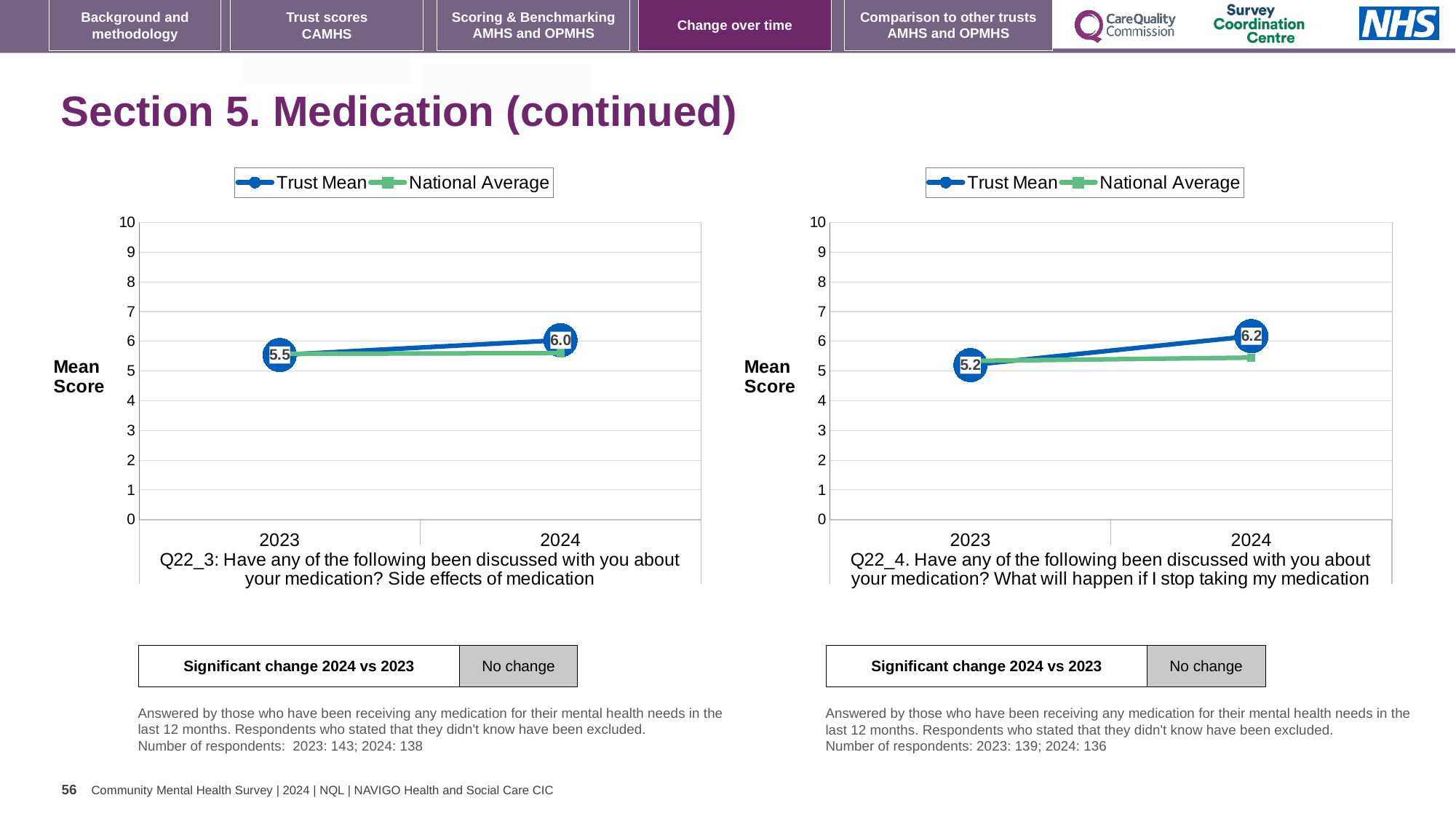
In the left chart (Q22_3), does the Trust Mean rise or fall from 2023 to 2024? rise In the left chart (Q22_3), by how much did the Trust Mean change from 2023 to 2024? 0.5 How many series does the legend of the left chart (Q22_3) list? 2 In the right chart (Q22_4), is the National Average value for 2024 greater or less than 6? less In the left chart (Q22_3: Side effects of medication), what is the Trust Mean score for 2024? 6.0 In the right chart (Q22_4: What will happen if I stop taking my medication), what is the Trust Mean score for 2024? 6.2 In the left chart (Q22_3: Side effects of medication), what is the Trust Mean score for 2023? 5.5 In the right chart (Q22_4: What will happen if I stop taking my medication), what is the Trust Mean score for 2023? 5.2 In the right chart (Q22_4), by how much did the Trust Mean change from 2023 to 2024? 1.0 How many years are shown on the x axis of the right chart (Q22_4)? 2 What type of chart is used on the right side of the slide (Q22_4)? line chart In the right chart (Q22_4), which is larger in 2024: the Trust Mean or the National Average? Trust Mean